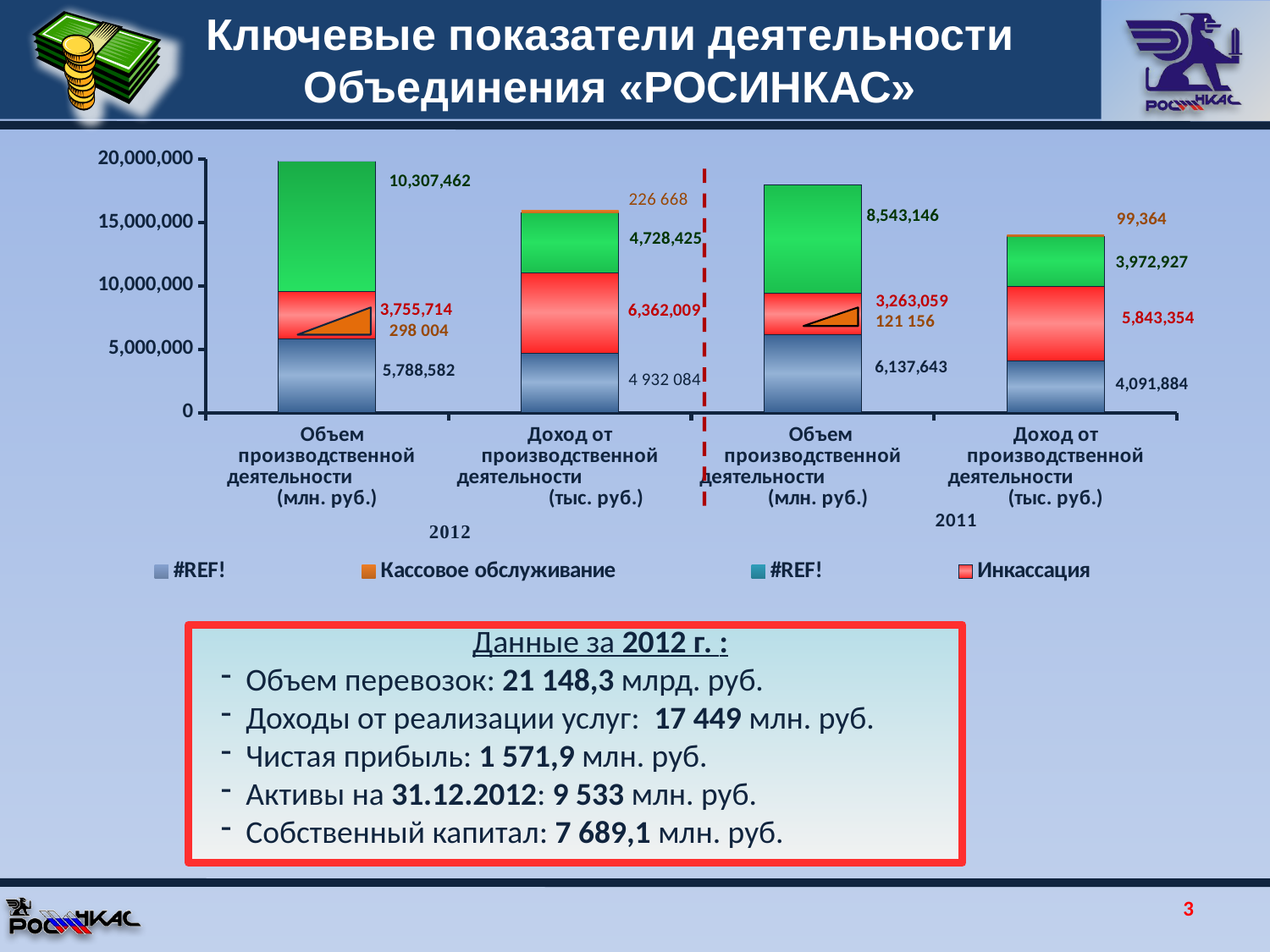
Which is larger: the green segment for 'Объем производственной деятельности' in 2012 or in 2011? 2012 What type of chart is shown on the slide? Stacked bar chart What is the value of the 'Инкассация' (red) segment for 'Доход от производственной деятельности (тыс. руб.)' in 2011? 5,843,354 What is the value of the green segment for 'Объем производственной деятельности (млн. руб.)' in 2012? 10,307,462 What is the value of the 'Кассовое обслуживание' (orange) segment for 'Объем производственной деятельности (млн. руб.)' in 2011? 121 156 What is the difference between the green segment values for 'Объем производственной деятельности' in 2012 (10,307,462) and 2011 (8,543,146)? 1,764,316 Is the total height of the 2012 'Объем производственной деятельности (млн. руб.)' bar greater or less than 15,000,000? greater What is the value of the bottom blue segment for 'Доход от производственной деятельности (тыс. руб.)' in 2012? 4 932 084 What is the difference between the 'Инкассация' values for 'Доход от производственной деятельности' in 2012 (6,362,009) and 2011 (5,843,354)? 518,655 Which legend entry is shown with an orange marker? Кассовое обслуживание How many entries does the chart legend list? 4 How many bars are plotted in the chart? 4